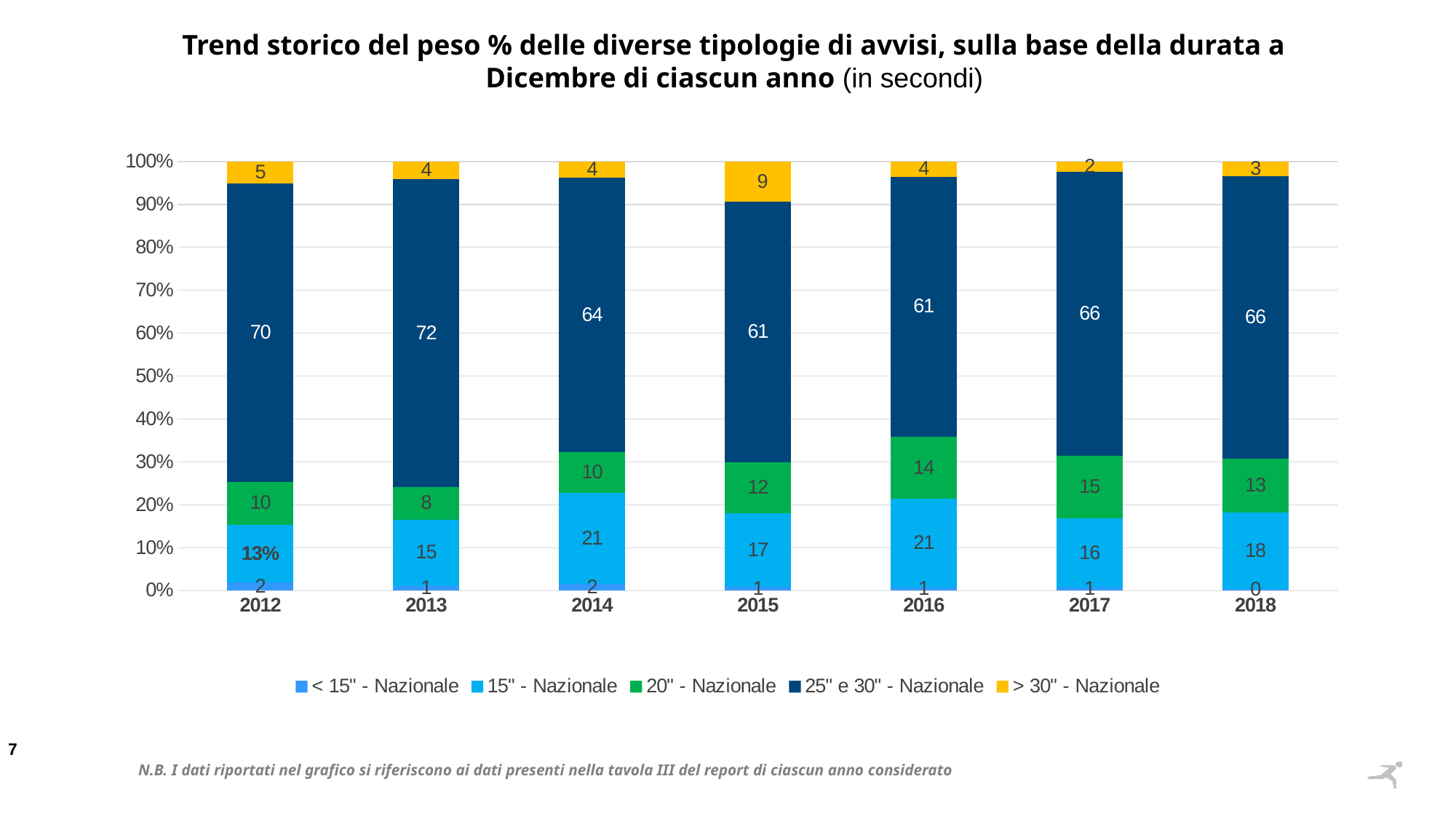
What is the value for the "15'' - Nazionale" series in 2018? 18 What is the difference between the "25'' e 30'' - Nazionale" values in 2013 and 2012? 2 What is the value for the "> 30'' - Nazionale" series in 2015? 9 Which year has the larger value for "15'' - Nazionale", 2013 or 2014? 2014 What is the value for the "25'' e 30'' - Nazionale" series in 2013? 72 In which year is the "> 30'' - Nazionale" series lowest? 2017 What kind of chart is shown on the slide? Stacked bar chart In which year is the "25'' e 30'' - Nazionale" series highest? 2013 How many years are shown on the x axis? 7 Which series is shown in yellow in the legend? > 30'' - Nazionale How many series does the legend list? 5 Does the "25'' e 30'' - Nazionale" series rise or fall from 2013 to 2015? Fall